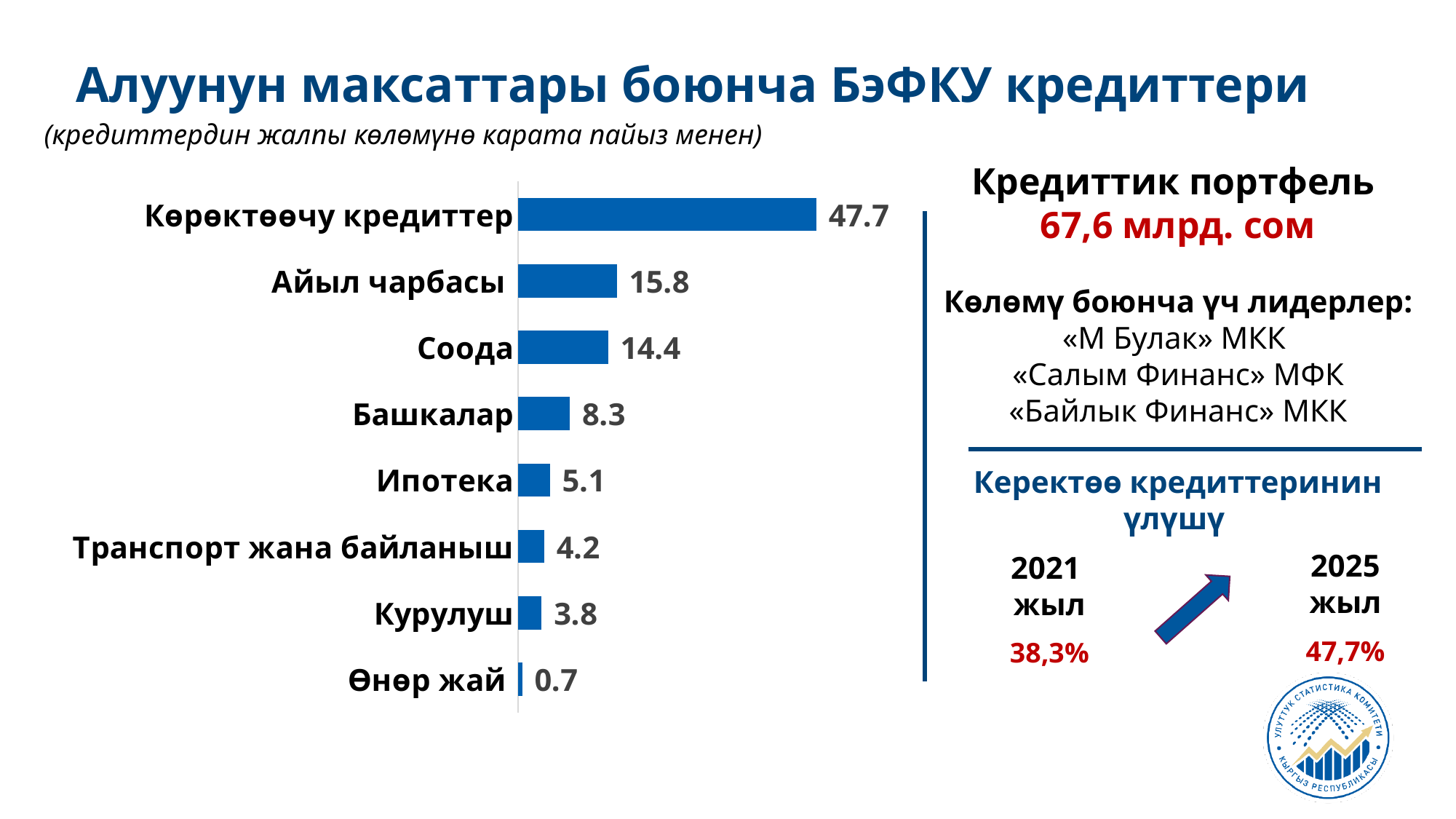
Which category has the lowest value? Өнөр жай What is the value for Айыл чарбасы? 15.8 How many categories are shown in the bar chart? 8 Which category has the highest value? Көрөктөөчу кредиттер Which is larger, the value for Транспорт жана байланыш or the value for Курулуш? Транспорт жана байланыш What is the title of the slide's chart? Алуунун максаттары боюнча БэФКУ кредиттери What kind of chart is shown on the slide? bar chart What is the value for Өнөр жай? 0.7 What is the value for Көрөктөөчу кредиттер? 47.7 What is the value for Ипотека? 5.1 What is the difference between the values for Айыл чарбасы and Соода? 1.4 What is the difference between the values for Башкалар and Курулуш? 4.5